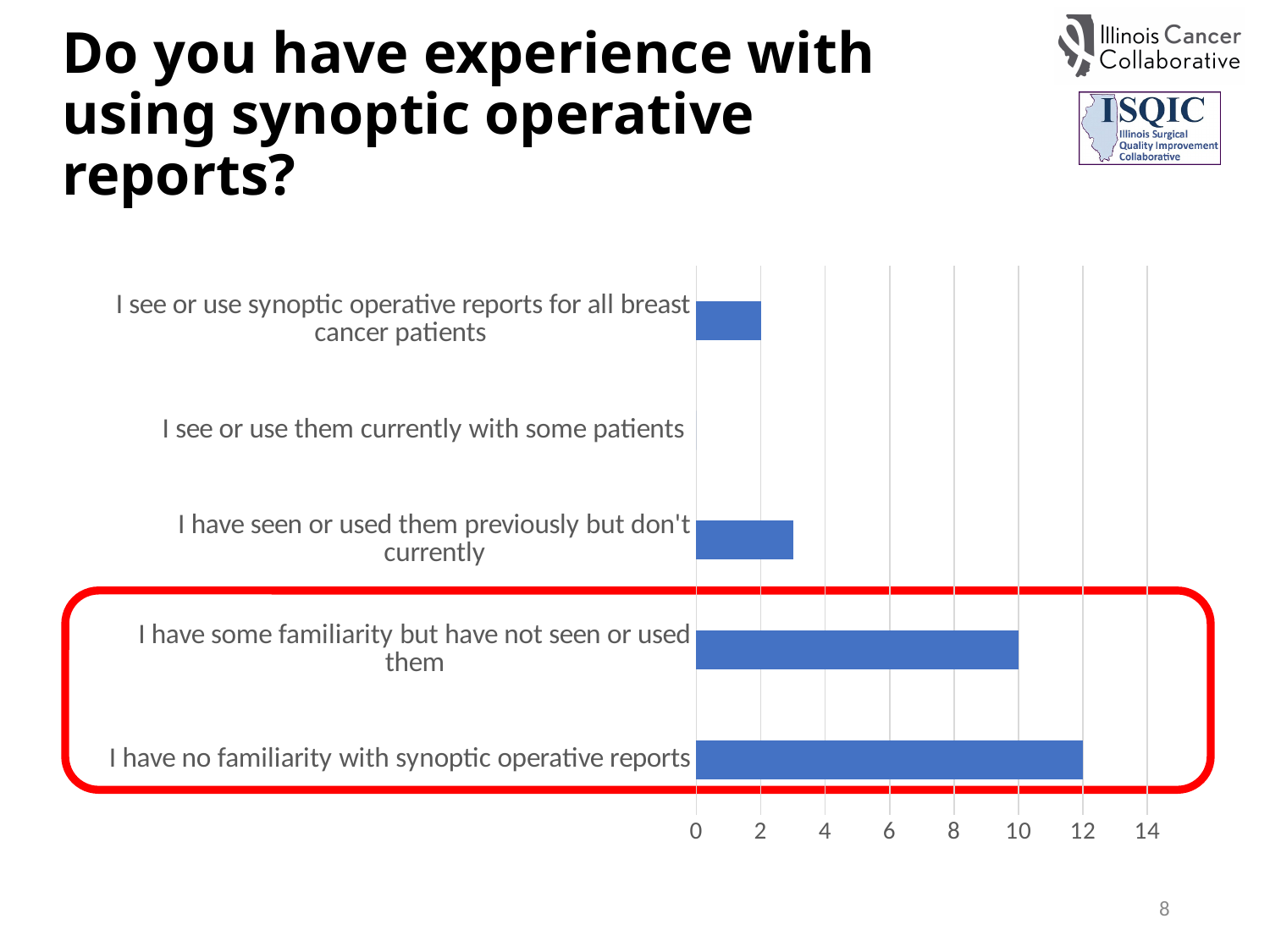
Which is larger: the value for "I have some familiarity but have not seen or used them" or the value for "I have seen or used them previously but don't currently"? I have some familiarity but have not seen or used them Is the value for "I have seen or used them previously but don't currently" greater or less than 4? less Which category has the highest value? I have no familiarity with synoptic operative reports What is the difference between the values for "I have no familiarity with synoptic operative reports" and "I have some familiarity but have not seen or used them"? 2 What colour are the bars in the chart? blue What is the value for "I have no familiarity with synoptic operative reports"? 12 What kind of chart is shown on the slide? bar chart What is the value for "I have some familiarity but have not seen or used them"? 10 What is the value for "I see or use synoptic operative reports for all breast cancer patients"? 2 What is the title of the slide containing the chart? Do you have experience with using synoptic operative reports? How many categories are plotted in the chart? 5 Which category has the lowest value? I see or use them currently with some patients